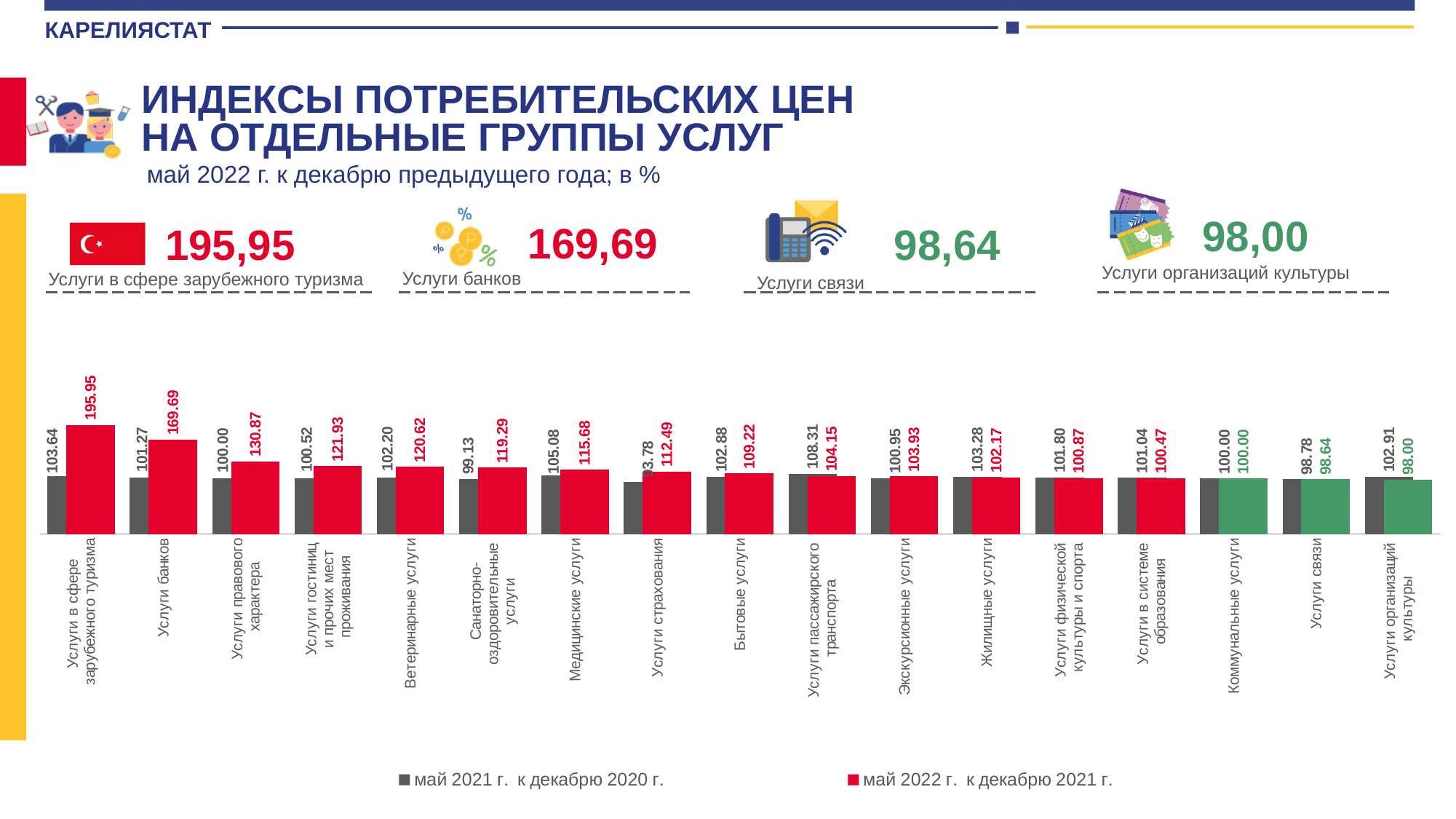
What is the value for Услуги страхования in the series май 2022 г. к декабрю 2021 г.? 112.49 How many series does the chart legend list? 2 What is the value for Медицинские услуги in the series май 2021 г. к декабрю 2020 г.? 105.08 What is the value for Услуги банков in the series май 2022 г. к декабрю 2021 г.? 169.69 Which category has the lowest value in the series май 2021 г. к декабрю 2020 г.? Услуги страхования Which category has the lowest value in the series май 2022 г. к декабрю 2021 г.? Услуги организаций культуры Which category has the highest value in the series май 2022 г. к декабрю 2021 г.? Услуги в сфере зарубежного туризма How many service categories are shown on the chart? 17 What type of chart is shown on the slide? bar chart What is the difference between the май 2022 г. к декабрю 2021 г. value and the май 2021 г. к декабрю 2020 г. value for Услуги правового характера? 30.87 What colour are the bars for Услуги связи and Услуги организаций культуры in the май 2022 г. к декабрю 2021 г. series? green For Услуги пассажирского транспорта, which series has the larger value: май 2021 г. к декабрю 2020 г. or май 2022 г. к декабрю 2021 г.? май 2021 г. к декабрю 2020 г.